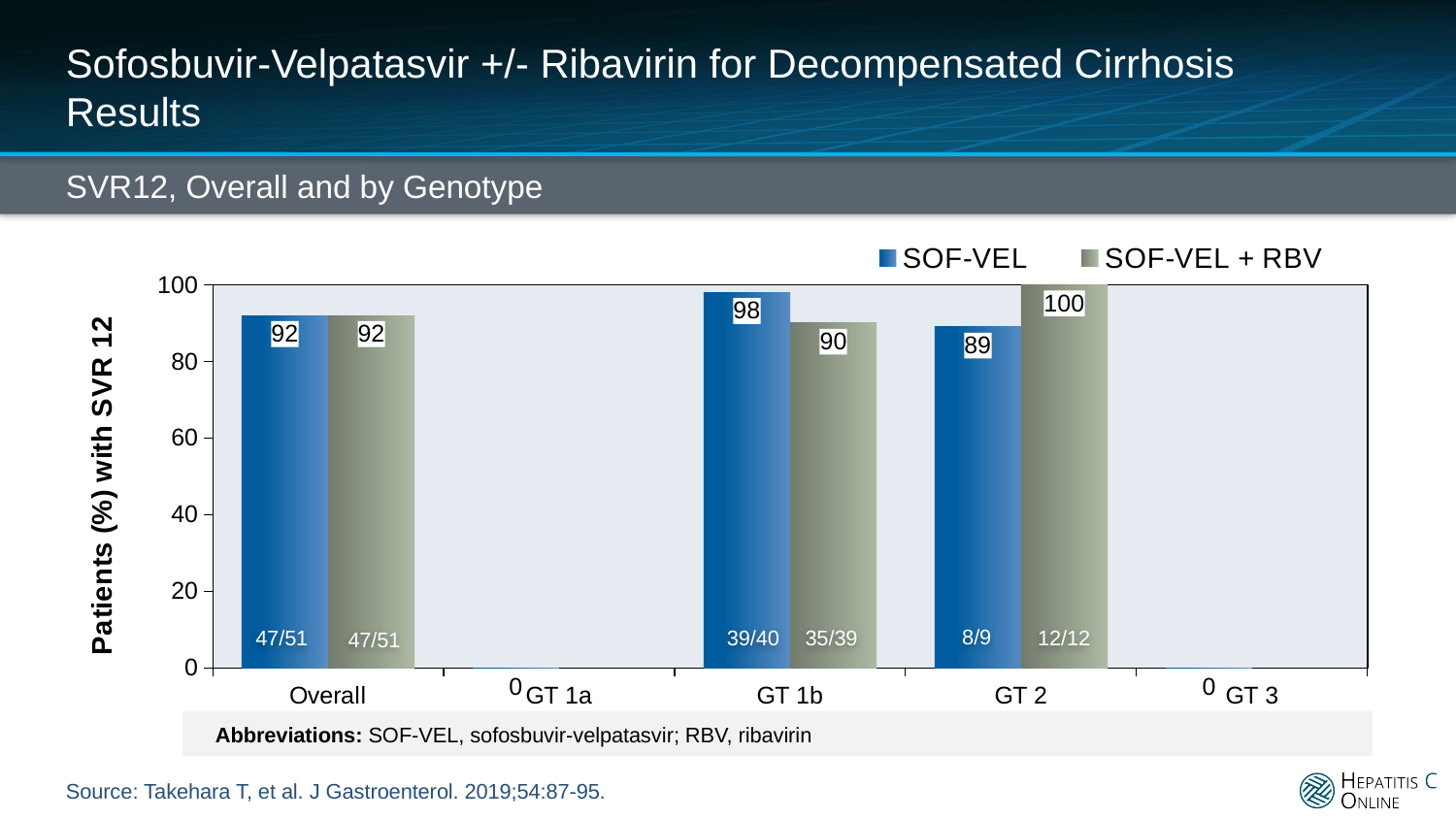
What is the SVR12 rate for SOF-VEL in the GT 1b group? 98 What is the difference between the SOF-VEL and SOF-VEL + RBV SVR12 rates in the GT 2 group? 11 What is the SVR12 rate for SOF-VEL + RBV in the GT 2 group? 100 Which group has the lowest SVR12 rate for SOF-VEL among Overall, GT 1b and GT 2? GT 2 What kind of chart is shown on the slide? Bar chart How many genotype categories are shown on the x axis? 5 In the GT 1b group, which is larger: the SVR12 rate for SOF-VEL or for SOF-VEL + RBV? SOF-VEL How many series does the legend list? 2 What is the SVR12 rate for SOF-VEL in the Overall group? 92 Which genotype group has the highest SVR12 rate for SOF-VEL + RBV? GT 2 What fraction of patients is shown for SOF-VEL + RBV in the GT 1b group? 35/39 What is the label of the y axis? Patients (%) with SVR 12